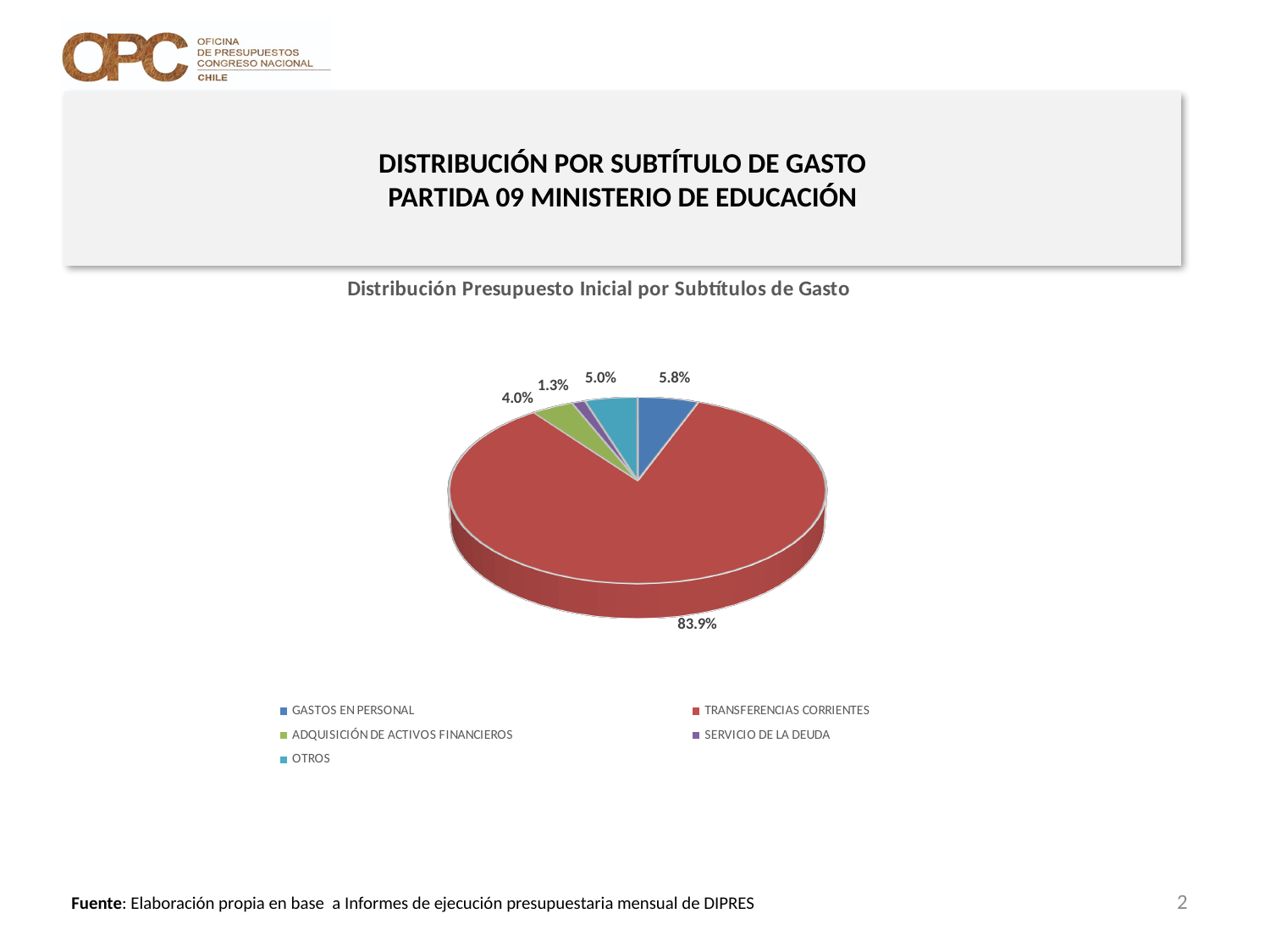
What share of the pie does GASTOS EN PERSONAL represent? 5.8% Which is larger, the share for GASTOS EN PERSONAL or the share for OTROS? GASTOS EN PERSONAL What share of the pie does TRANSFERENCIAS CORRIENTES represent? 83.9% What share of the pie does ADQUISICIÓN DE ACTIVOS FINANCIEROS represent? 4.0% What is the title of the chart? Distribución Presupuesto Inicial por Subtítulos de Gasto How many categories does the legend list? 5 What kind of chart is shown on the slide? pie chart Which category has the largest slice of the pie? TRANSFERENCIAS CORRIENTES Which category has the smallest slice of the pie? SERVICIO DE LA DEUDA What is the difference between the share for GASTOS EN PERSONAL and the share for ADQUISICIÓN DE ACTIVOS FINANCIEROS? 1.8%